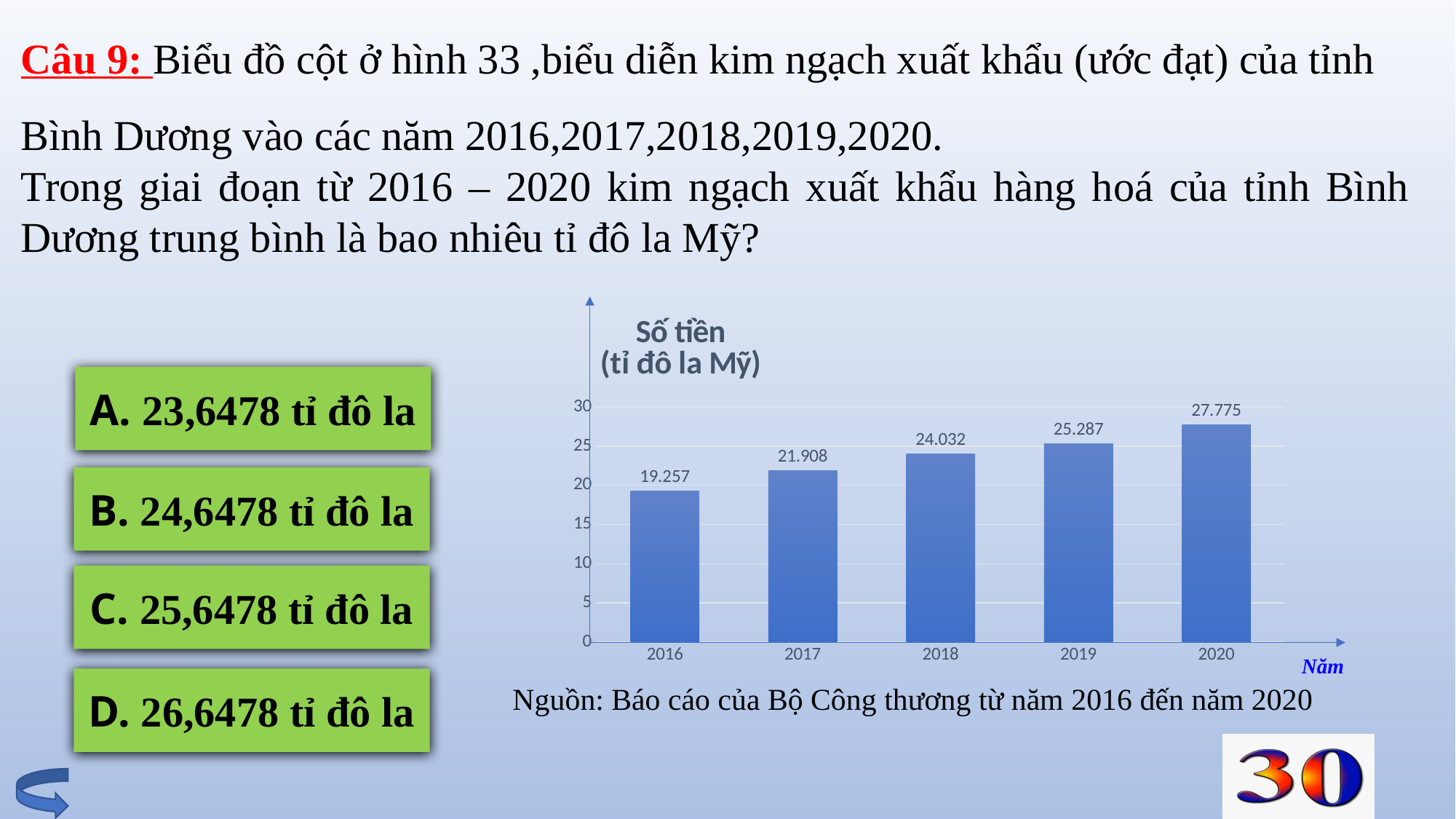
Which year has the highest value? 2020 What is the difference between the values for 2020 and 2016? 8.518 What is the value for 2018? 24.032 What kind of chart is shown? bar chart What is the value for 2016? 19.257 What is the difference between the values for 2019 and 2018? 1.255 Do the values rise or fall from 2016 to 2020? rise Which is larger, the value for 2017 or the value for 2019? 2019 What is the value for 2020? 27.775 Is the value for 2017 greater or less than 25? less Which year has the lowest value? 2016 How many years are shown on the x axis? 5